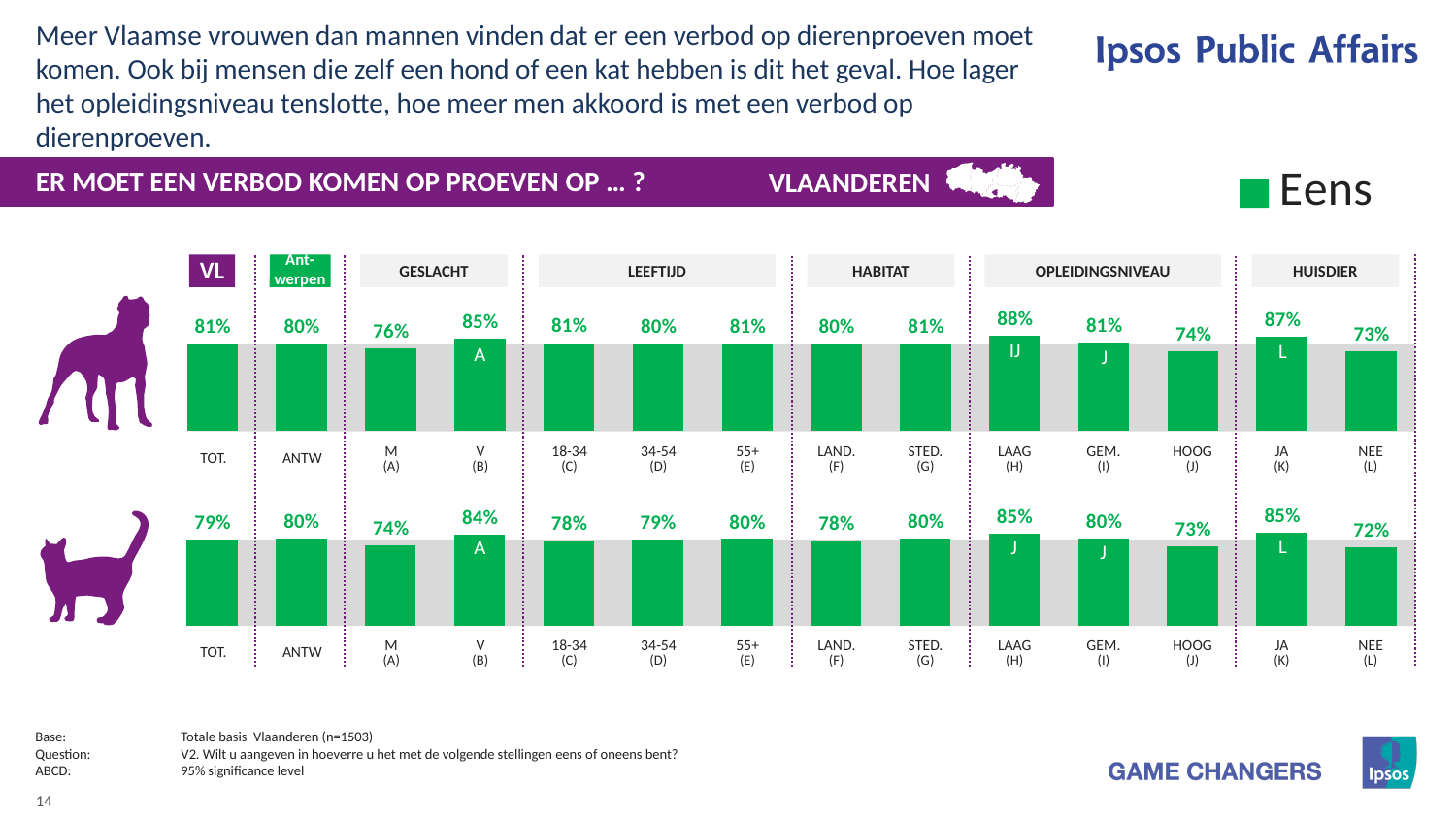
What kind of chart is shown on the slide? Bar chart In the top row of bars (dog), which category has the highest value? LAAG (H) In the bottom row of bars (cat), what is the difference between LAAG (H) and HOOG (J) under OPLEIDINGSNIVEAU? 12% In the top row of bars (dog), what is the value for TOT.? 81% In the bottom row of bars (cat), what is the value for NEE (L) under HUISDIER? 72% In the bottom row of bars (cat), which is larger: JA (K) or NEE (L) under HUISDIER? JA (K) In the top row of bars (dog), what is the difference between V (B) and M (A) under GESLACHT? 9% In the top row of bars (dog), which category has the lowest value? NEE (L) In the bottom row of bars (cat), what is the value for V (B) under GESLACHT? 84% In the bottom row of bars (cat), which category has the lowest value? NEE (L) In the top row of bars (dog), what is the value for LAAG (H) under OPLEIDINGSNIVEAU? 88% How many bars are in the top row of bars (dog)? 14